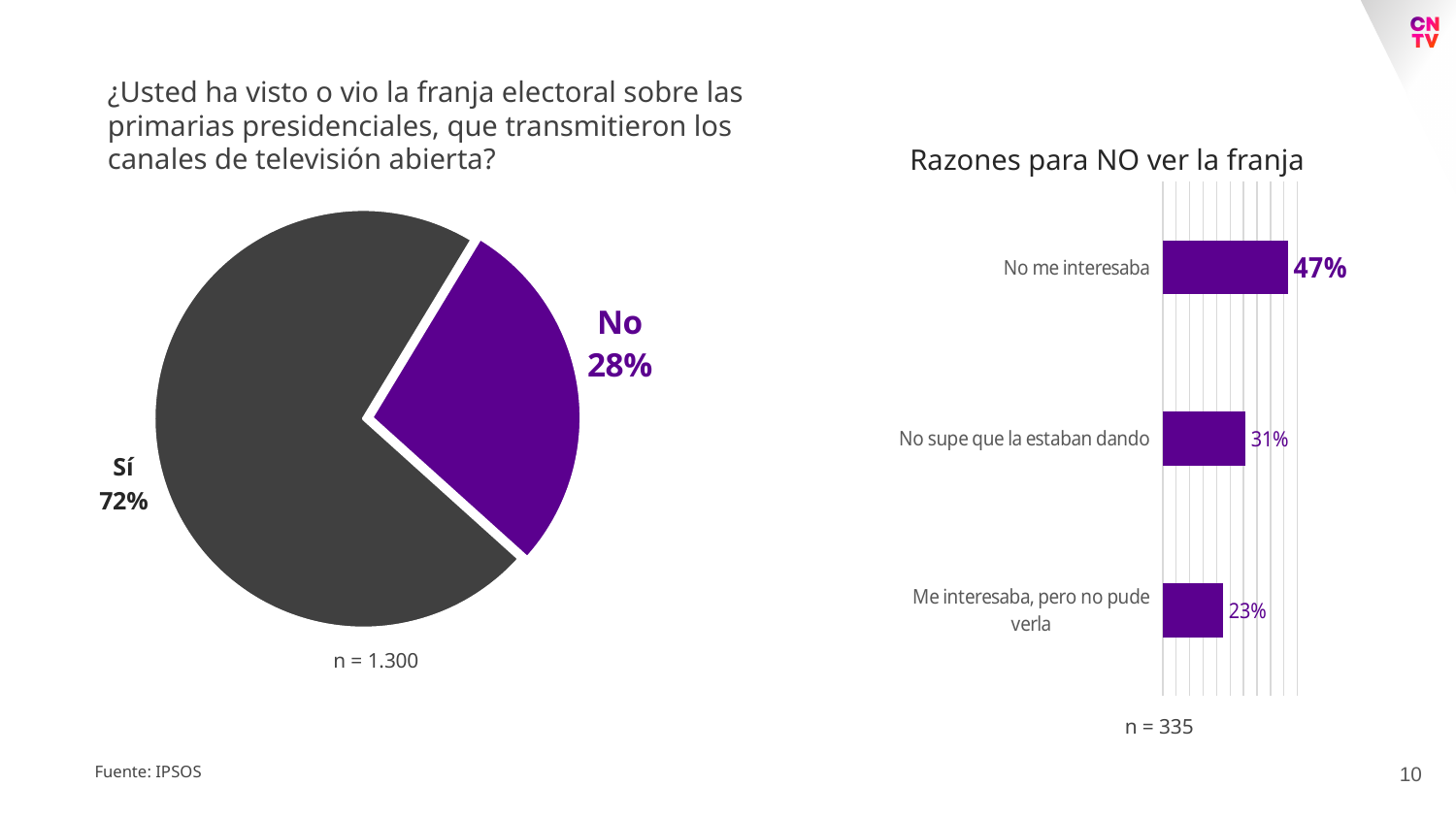
In the "Razones para NO ver la franja" chart, what is the value for "Me interesaba, pero no pude verla"? 23% In the "Razones para NO ver la franja" chart, how many categories are shown? 3 In the "Razones para NO ver la franja" chart, which reason has the highest value? No me interesaba In the "Razones para NO ver la franja" chart, what is the value for "No supe que la estaban dando"? 31% In the pie chart on the left, what percentage of respondents answered "No"? 28% In the "Razones para NO ver la franja" chart, what is the value for "No me interesaba"? 47% In the pie chart on the left, which response has the larger share, "Sí" or "No"? Sí What type of chart is shown on the left side of the slide? Pie chart In the "Razones para NO ver la franja" chart, which reason has the lowest value? Me interesaba, pero no pude verla In the pie chart on the left, what percentage of respondents answered "Sí"? 72% In the pie chart on the left, what is the difference in percentage points between "Sí" and "No"? 44 What type of chart is "Razones para NO ver la franja"? Bar chart